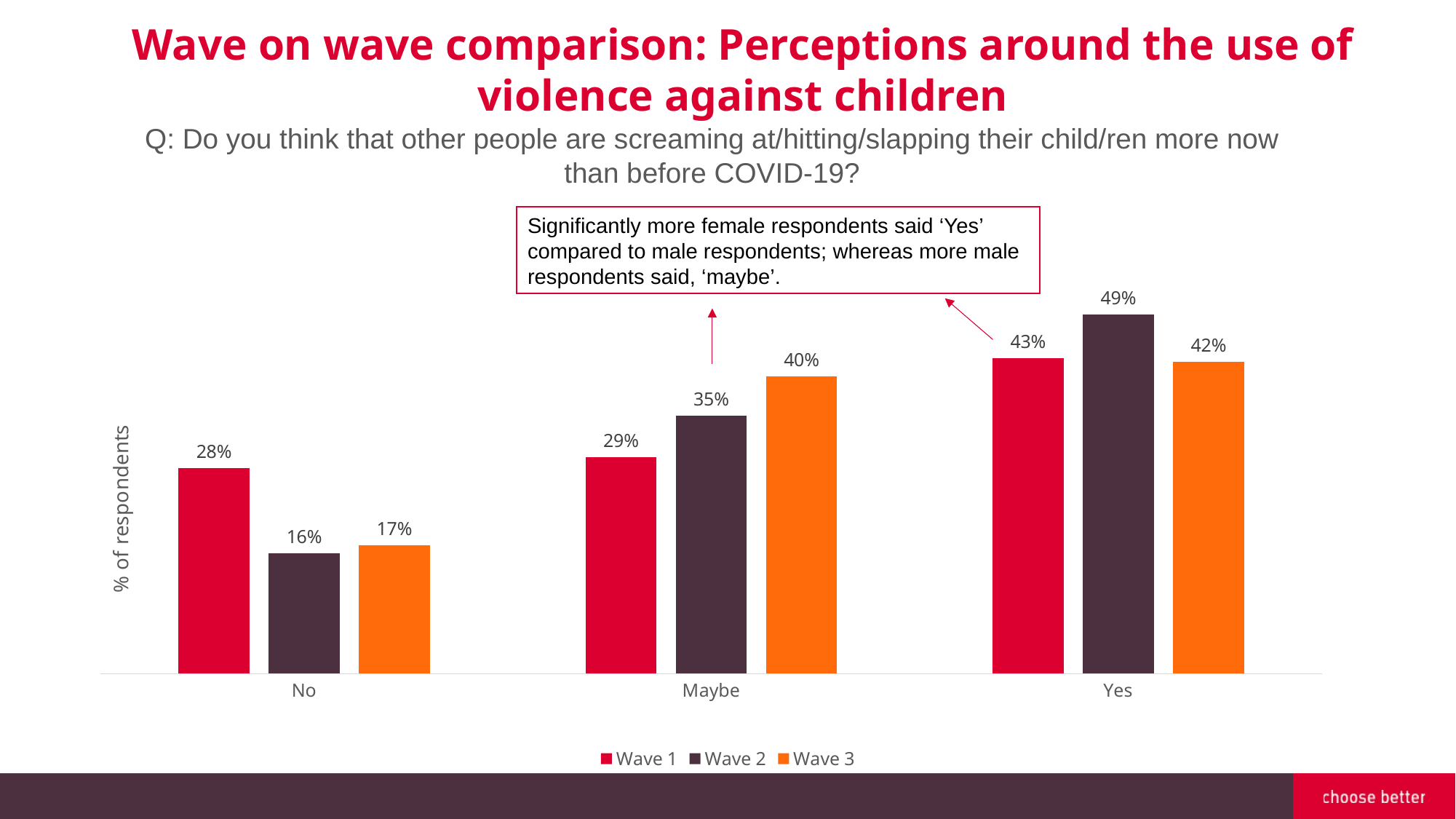
What percentage of respondents answered 'Maybe' in Wave 3? 40% What kind of chart is shown on the slide? Bar chart Which response category has the highest value in Wave 3? Yes How many response categories are shown on the x axis? 3 What is the difference between the Wave 2 and Wave 1 values for 'Yes'? 6% What is the difference between the Wave 1 and Wave 2 values for 'No'? 12% How many series does the legend list? 3 Which is larger for 'Maybe': the Wave 1 value or the Wave 3 value? Wave 3 Which response category has the lowest value in Wave 2? No What percentage of respondents answered 'Yes' in Wave 2? 49% What percentage of respondents answered 'No' in Wave 1? 28% What is the label of the y axis? % of respondents